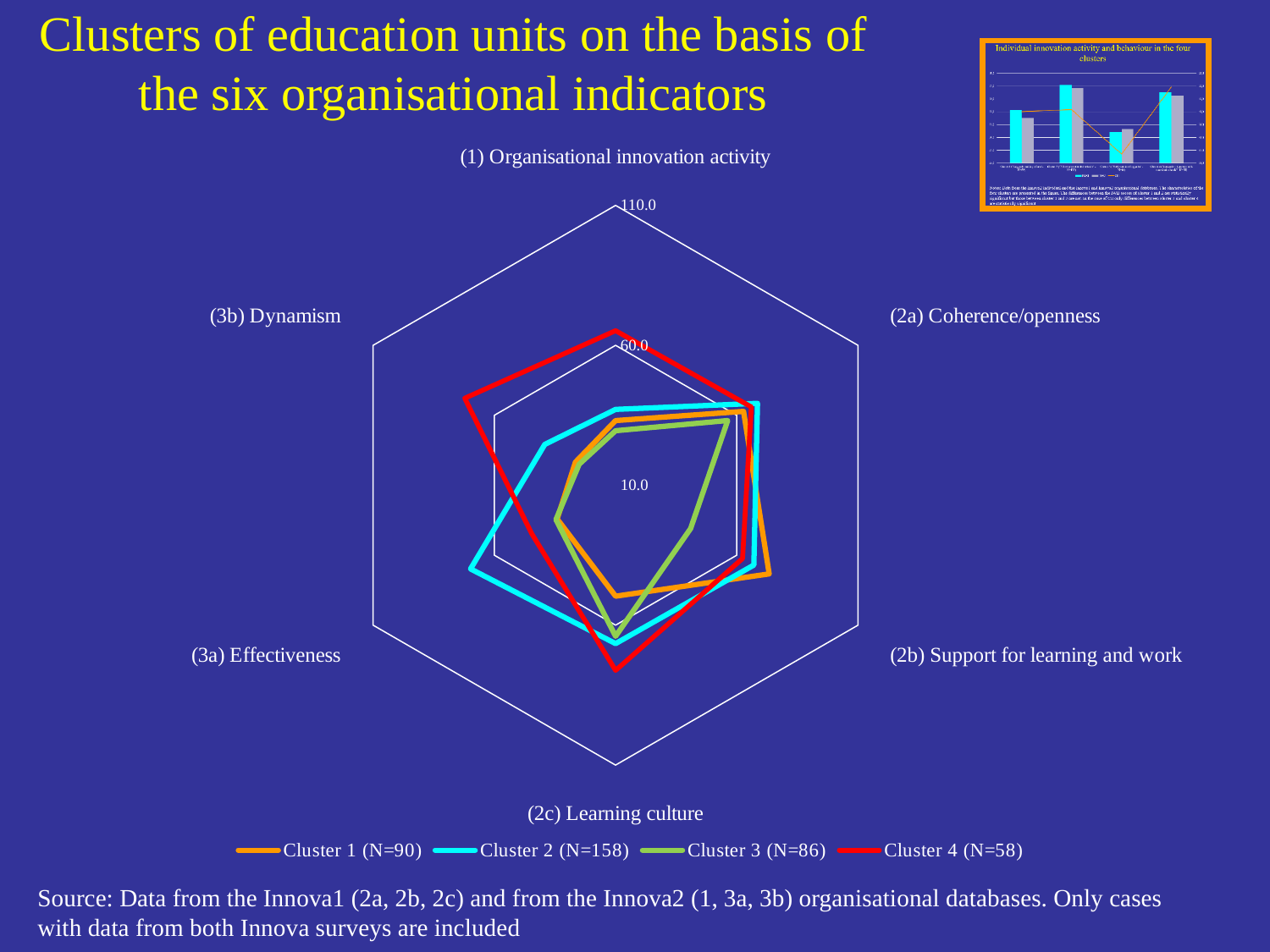
Is the value for Cluster 3 on (3a) Effectiveness greater or less than 60.0? less On (3b) Dynamism, which is larger: the value for Cluster 4 or the value for Cluster 3? Cluster 4 Is the value for Cluster 4 on (3b) Dynamism greater or less than 60.0? greater Which cluster has the highest value on (2c) Learning culture? Cluster 4 (N=58) How many indicator axes does the radar chart have? 6 According to the legend, how many cases are in Cluster 2? 158 Is the value for Cluster 2 on (3a) Effectiveness greater or less than 60.0? greater Which cluster has the highest value on (1) Organisational innovation activity? Cluster 4 (N=58) What kind of chart is the main chart on the slide? Radar chart What is the highest value shown on the radar chart's axis scale? 110.0 How many series does the legend of the radar chart list? 4